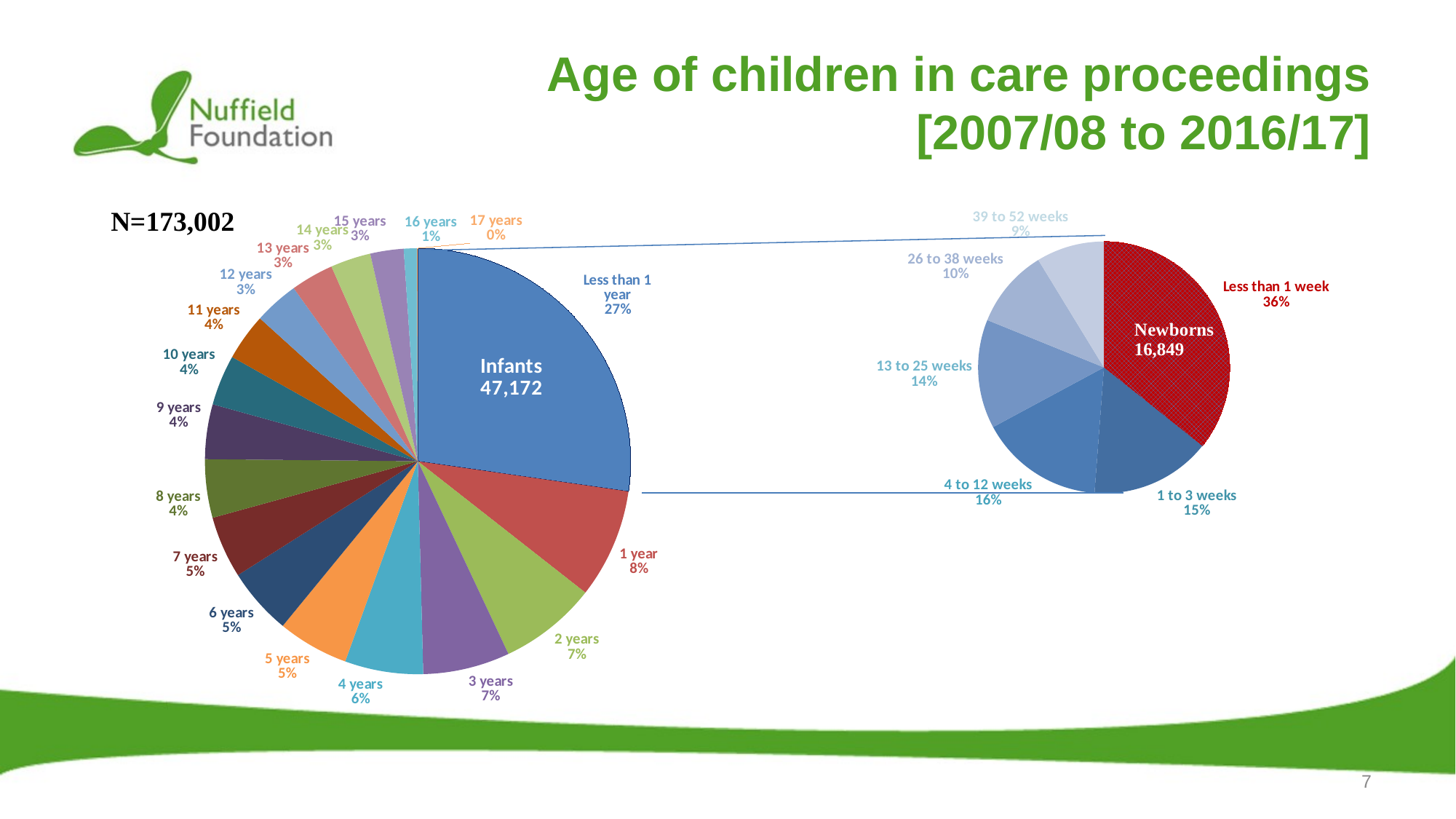
In the large pie chart on the left, which age category has the smallest share? 17 years What type of chart is used on this slide? Pie chart In the small pie chart on the right, which category has the smallest share? 39 to 52 weeks In the large pie chart on the left, how many infants are shown in the 'Infants' slice? 47,172 How many categories does the small pie chart on the right have? 6 In the small pie chart on the right, how many newborns are shown in the 'Newborns' slice? 16,849 In the small pie chart on the right, what percentage is shown for '4 to 12 weeks'? 16% In the large pie chart on the left, which age category has the largest share? Less than 1 year In the small pie chart on the right, which category has the largest share? Less than 1 week In the small pie chart on the right, how many percentage points larger is 'Less than 1 week' than '13 to 25 weeks'? 22 percentage points In the large pie chart on the left, which has the larger share: '4 years' or '12 years'? 4 years In the large pie chart on the left, what percentage of children are 'Less than 1 year' old? 27%